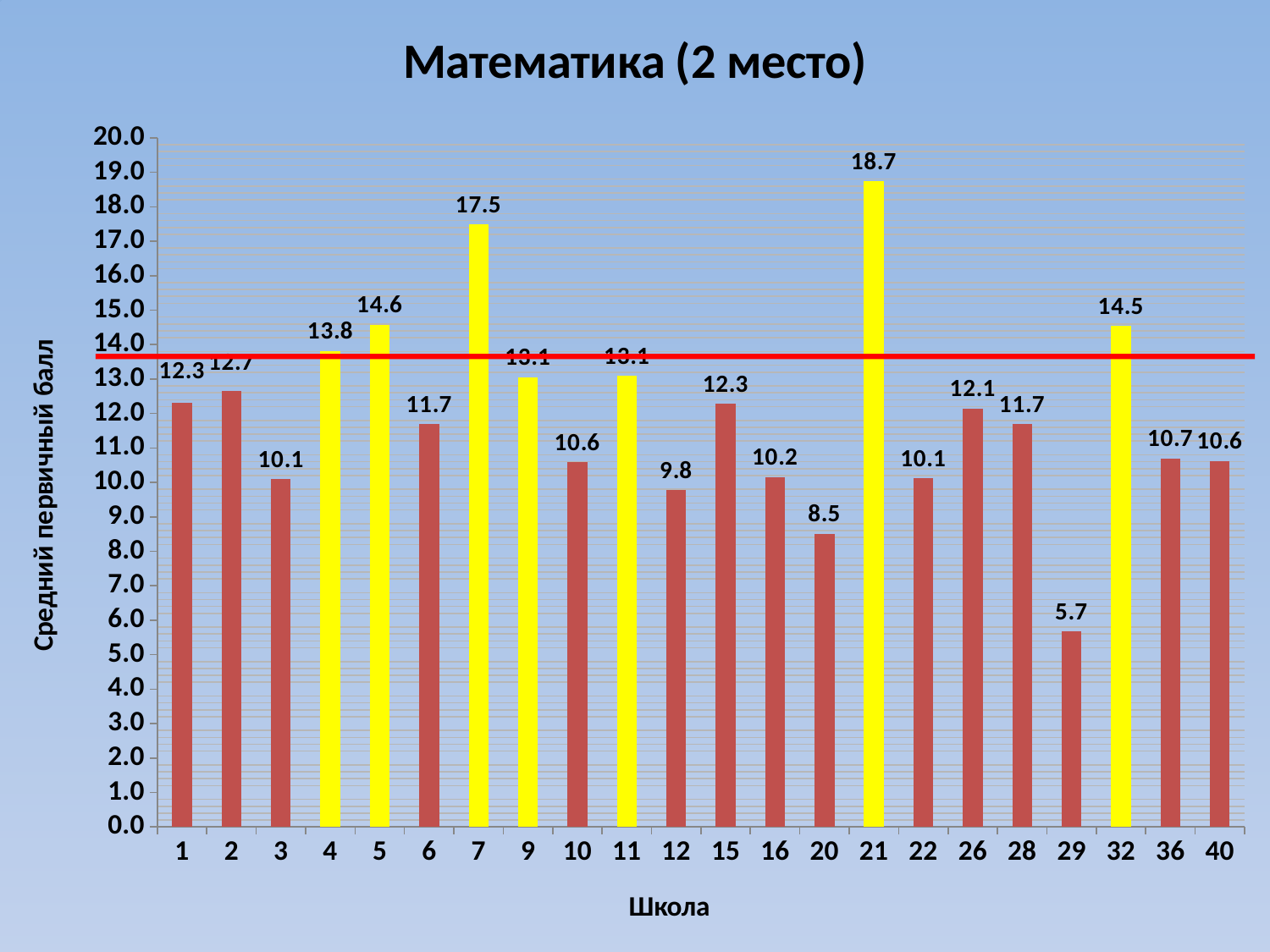
What is the average primary score for school 7? 17.5 How many bars are coloured yellow? 7 Which school has the highest average primary score? 21 What kind of chart is shown on the slide? bar chart Which has a higher value, school 5 or school 4? school 5 How many schools are shown on the x axis? 22 What is the average primary score for school 21? 18.7 What is the difference between the values for school 21 and school 29? 13.0 Is the value for school 20 greater or less than 10.0? less What is the value shown for school 29? 5.7 Which school has the lowest average primary score? 29 What is the difference between the values for school 7 and school 32? 3.0